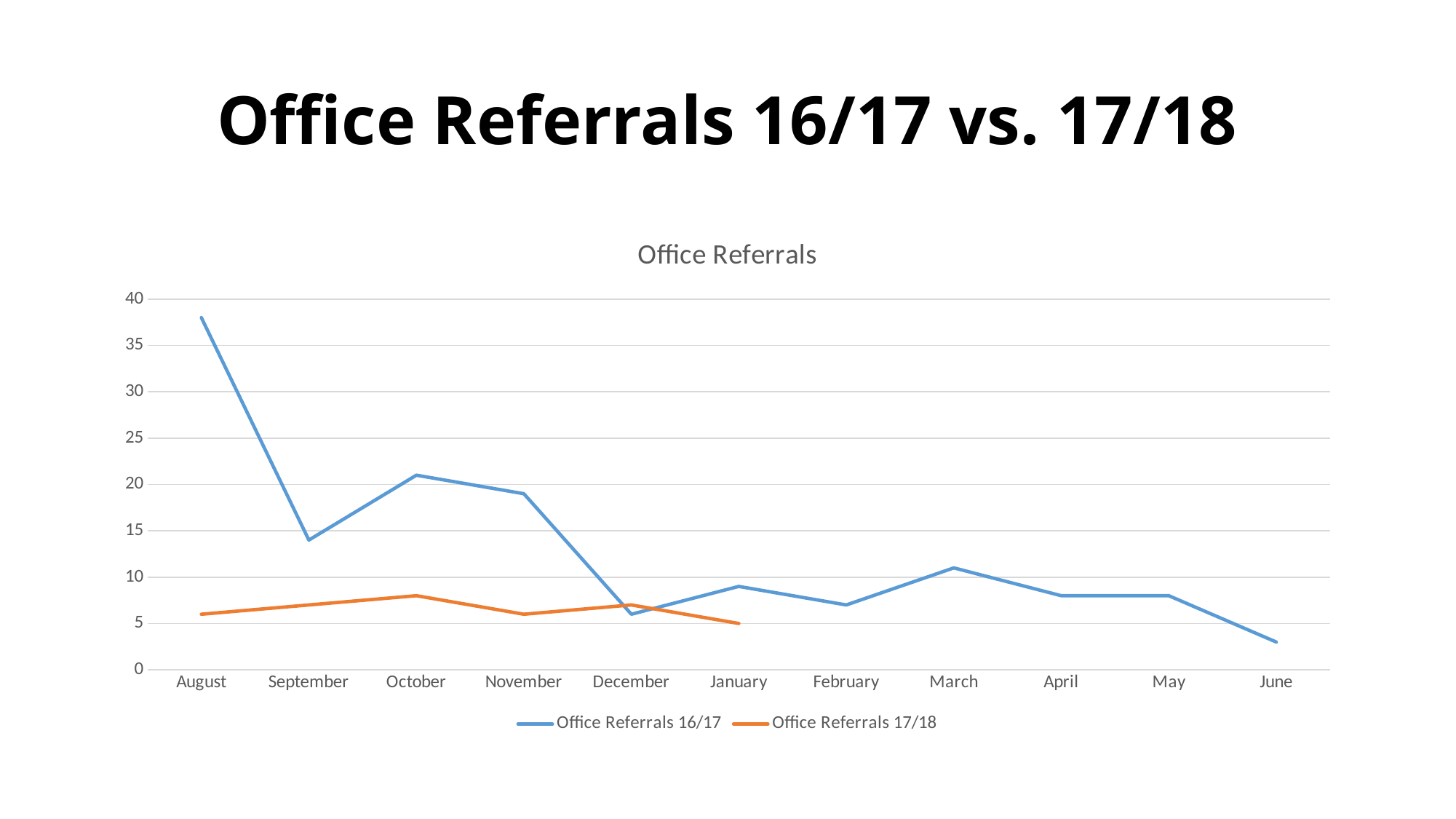
How many series does the legend list? 2 In which month is the Office Referrals 16/17 series highest? August In which month is the Office Referrals 16/17 series lowest? June Does the Office Referrals 16/17 series rise or fall from August to September? fall Is the value for Office Referrals 16/17 in August greater or less than 35? greater What kind of chart is shown on the slide? line chart Is the value for Office Referrals 16/17 in December greater or less than 10? less What is the title shown above the chart? Office Referrals Is the value for Office Referrals 17/18 in October greater or less than 10? less Which series has the larger value in August, Office Referrals 16/17 or Office Referrals 17/18? Office Referrals 16/17 How many months are shown on the x axis? 11